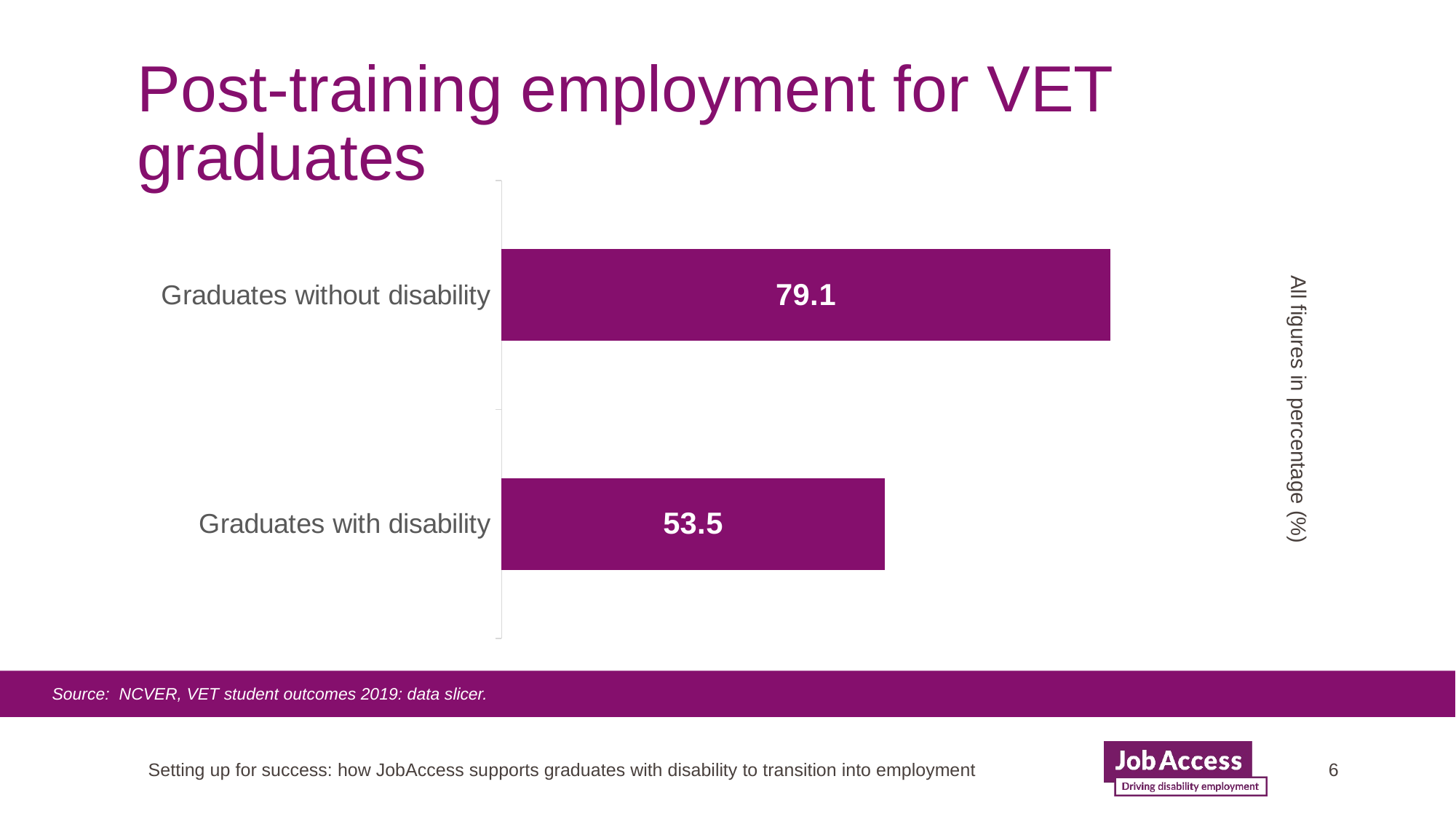
What is the value for Graduates with disability? 53.5 What is the difference between the values for Graduates without disability and Graduates with disability? 25.6 Which is larger: the value for Graduates with disability or the value for Graduates without disability? Graduates without disability What is the value for Graduates without disability? 79.1 What is the title of the slide containing the chart? Post-training employment for VET graduates Which category has the highest value? Graduates without disability What kind of chart is shown on the slide? Bar chart How many categories are shown in the chart? 2 Which category has the lowest value? Graduates with disability According to the note beside the chart, what unit are all figures in? Percentage (%)